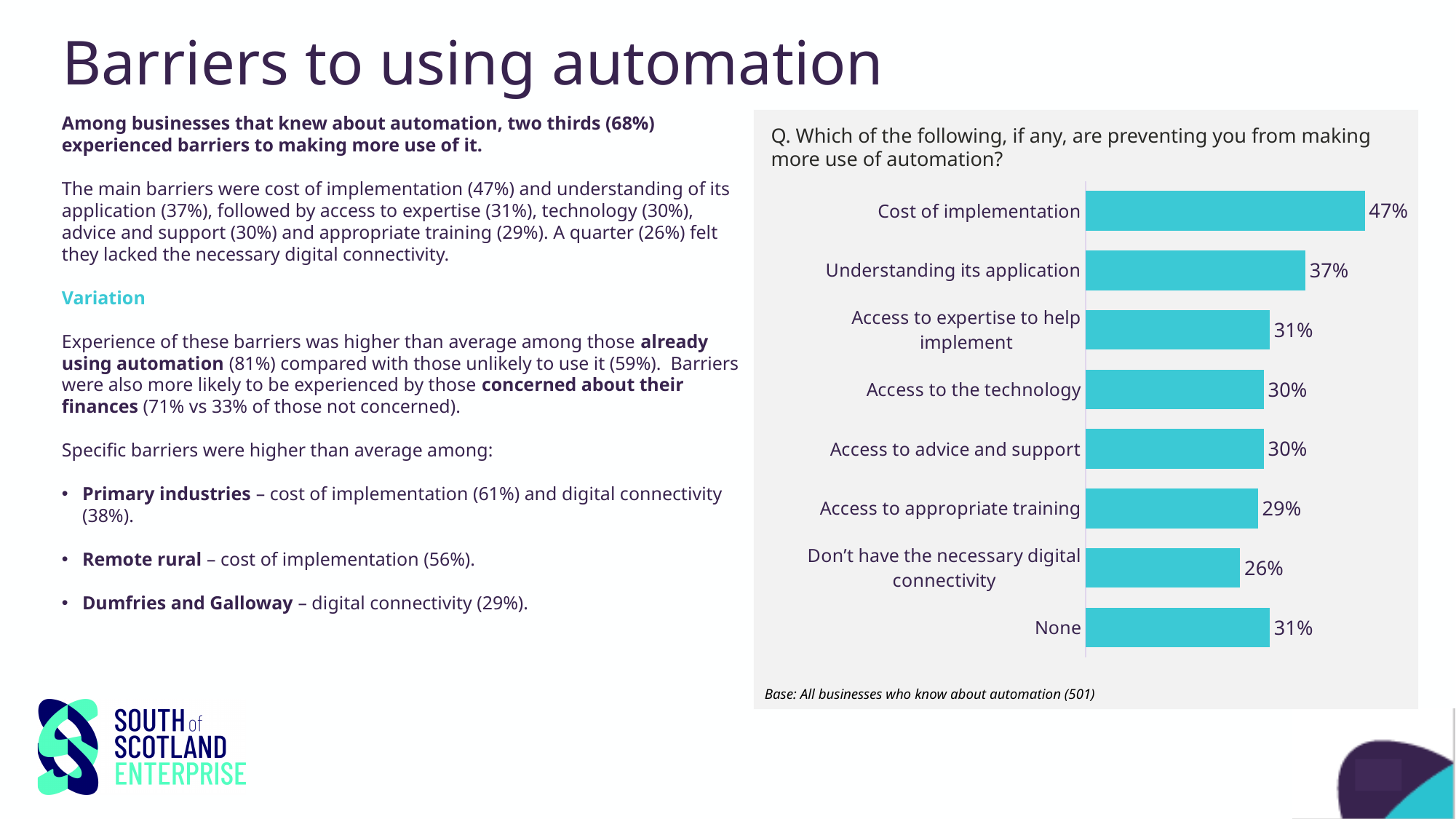
Which is larger: the value for 'Access to appropriate training' or the value for 'Don't have the necessary digital connectivity'? Access to appropriate training What percentage of businesses answered 'None' to the question about barriers to automation? 31% Which barrier has the highest percentage in the chart? Cost of implementation What value is shown for 'Understanding its application' in the chart? 37% What percentage of businesses cited cost of implementation as a barrier to making more use of automation? 47% Which category has the lowest percentage in the chart? Don't have the necessary digital connectivity What type of chart is used to show the barriers to using automation? Bar chart What colour are the bars in the chart? Teal How many categories are shown in the bar chart? 8 What is the base (number of respondents) stated beneath the chart? All businesses who know about automation (501) What percentage of businesses said they don't have the necessary digital connectivity? 26% What is the difference in percentage points between 'Cost of implementation' and 'Understanding its application'? 10 percentage points